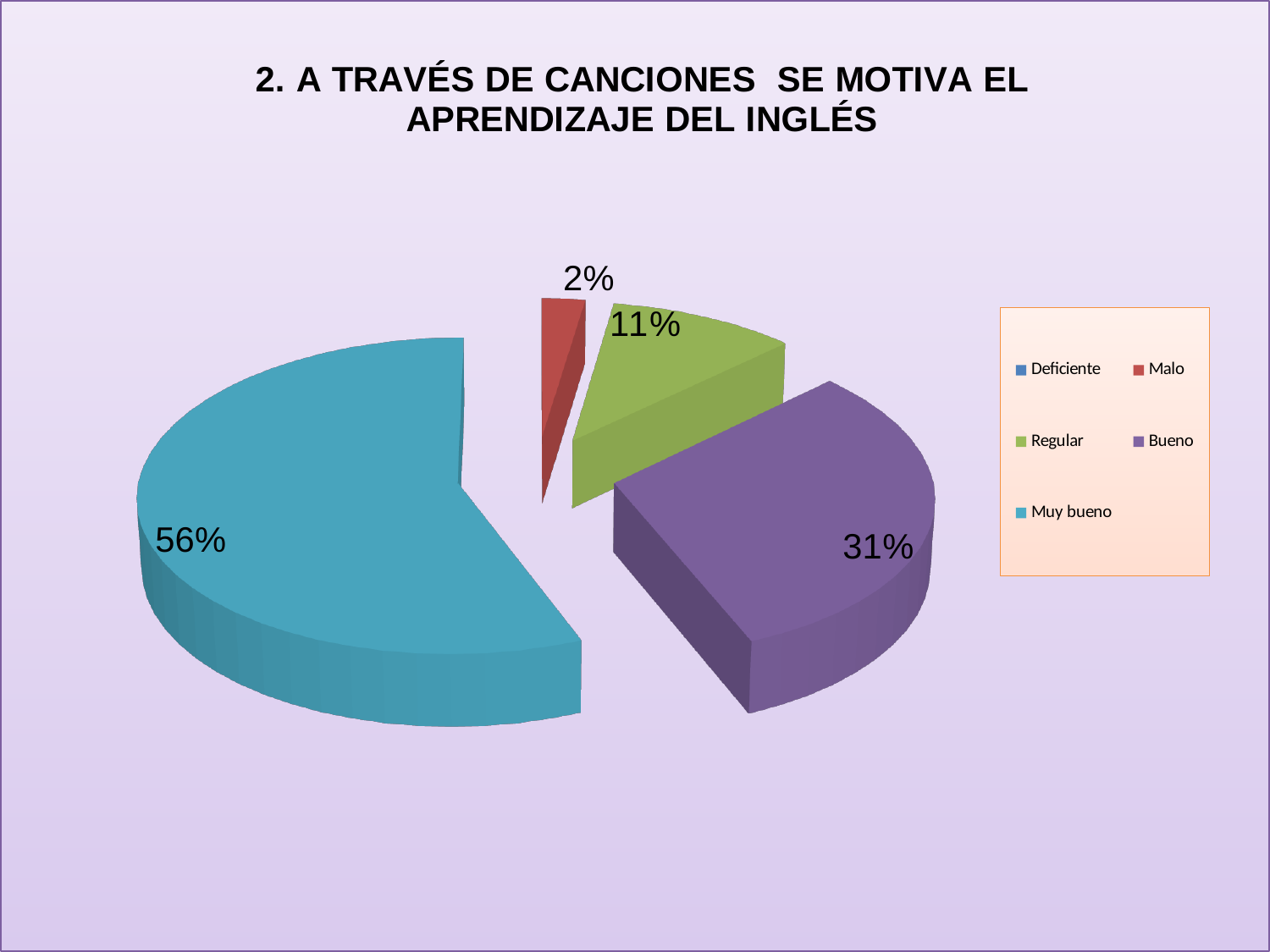
What percentage does the Muy bueno slice represent? 56% What percentage does the Malo slice represent? 2% What kind of chart is shown on the slide? Pie chart Which of the visible slices has the smallest share of the pie? Malo Which category has the largest share of the pie? Muy bueno Which slice is larger, Regular or Bueno? Bueno What colour is the Bueno slice? Purple What percentage does the Regular slice represent? 11% What is the difference in percentage points between the Muy bueno and Bueno slices? 25 percentage points How many categories does the legend list? 5 What is the title of the chart? 2. A TRAVÉS DE CANCIONES SE MOTIVA EL APRENDIZAJE DEL INGLÉS What percentage does the Bueno slice represent? 31%